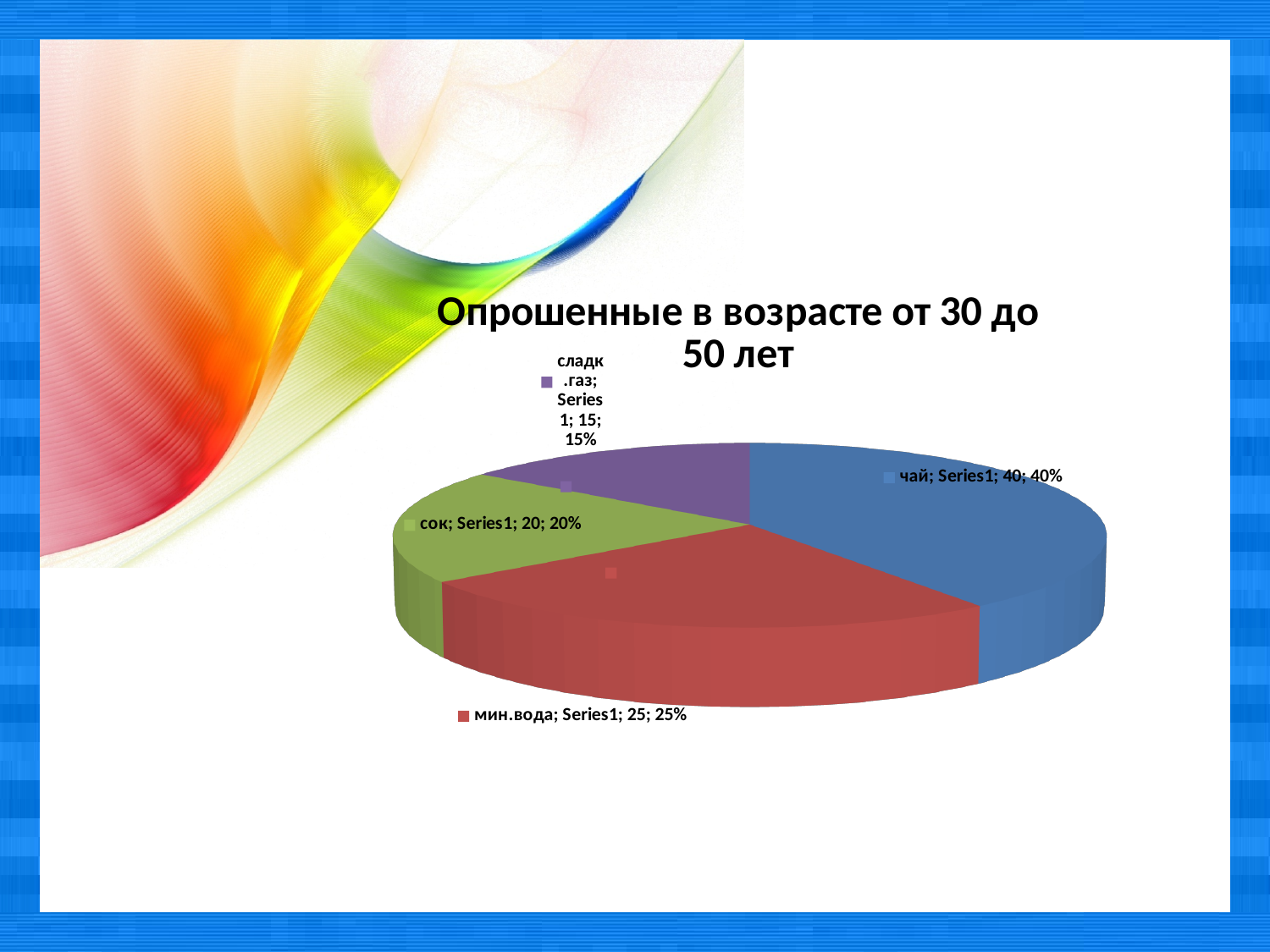
What is the value for сладк.газ? 15 What share of the pie does сок represent? 20% What is the value for мин.вода? 25 How many slices does the pie chart have? 4 Which category has the smallest slice? сладк.газ What is the difference between the values for чай and мин.вода? 15 What is the value for чай? 40 What is the value for сок? 20 Which is larger, the value for мин.вода or the value for сладк.газ? мин.вода Which category has the largest slice? чай What is the title of the chart? Опрошенные в возрасте от 30 до 50 лет What type of chart is shown on the slide? pie chart